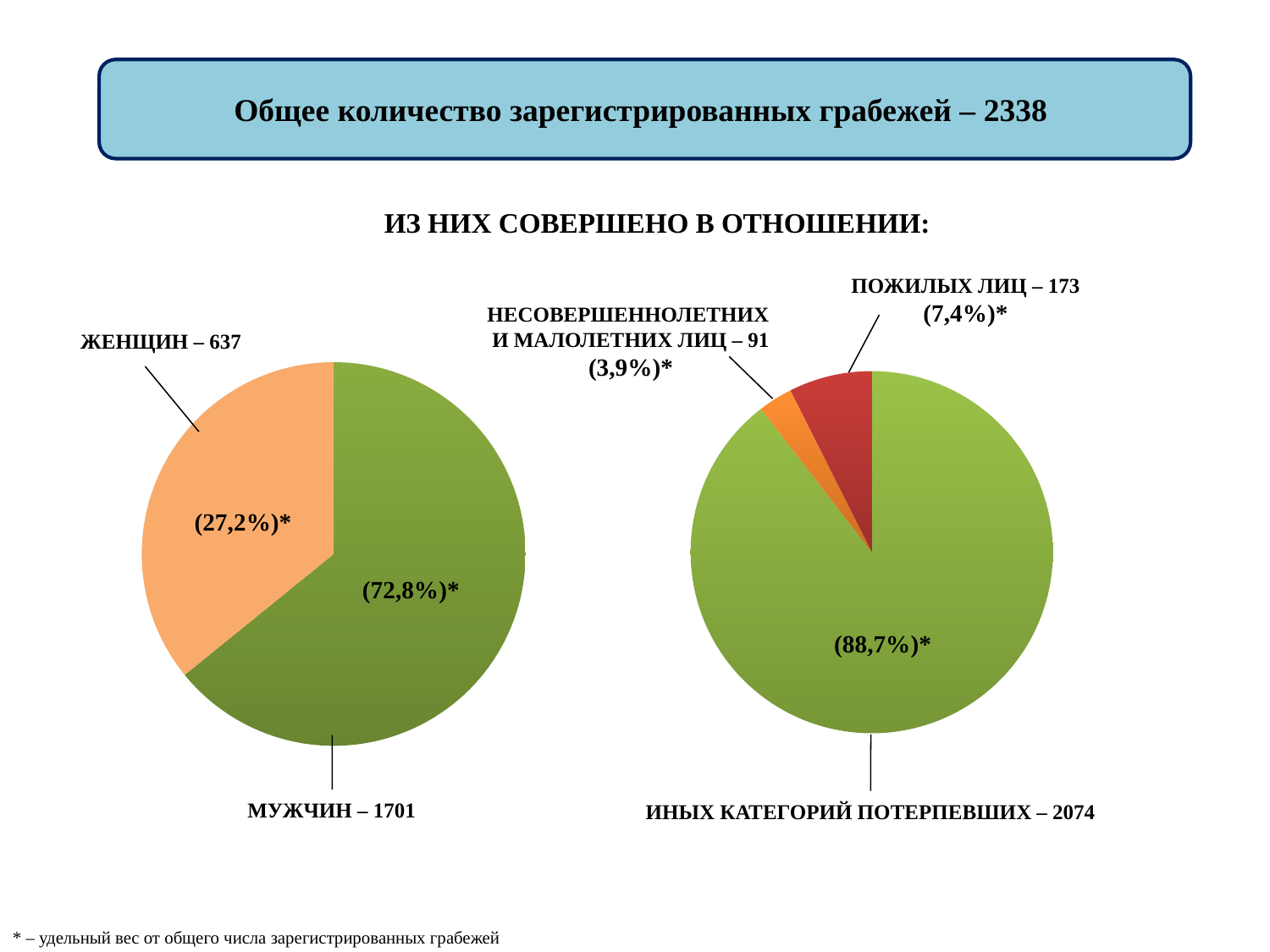
How many slices does the right pie chart have? 3 In the right pie chart, how many robberies were committed against minors and juveniles (НЕСОВЕРШЕННОЛЕТНИХ И МАЛОЛЕТНИХ ЛИЦ)? 91 In the right pie chart, which is larger: the number of robberies against elderly persons or against minors and juveniles? Elderly persons (ПОЖИЛЫХ ЛИЦ) In the right pie chart, which category has the smallest slice? НЕСОВЕРШЕННОЛЕТНИХ И МАЛОЛЕТНИХ ЛИЦ What type of chart is used on the left side of the slide? Pie chart In the left pie chart, what is the difference between the number of robberies against men and against women? 1064 In the right pie chart, what share of the total do other categories of victims (ИНЫХ КАТЕГОРИЙ ПОТЕРПЕВШИХ) represent? 88,7% In the left pie chart, how many robberies were committed against men (МУЖЧИН)? 1701 In the right pie chart, how many robberies were committed against elderly persons (ПОЖИЛЫХ ЛИЦ)? 173 In the left pie chart, what share of the total do robberies against women (ЖЕНЩИН) represent? 27,2% In the left pie chart, how many robberies were committed against women (ЖЕНЩИН)? 637 In the left pie chart, what share of the total do robberies against men (МУЖЧИН) represent? 72,8%